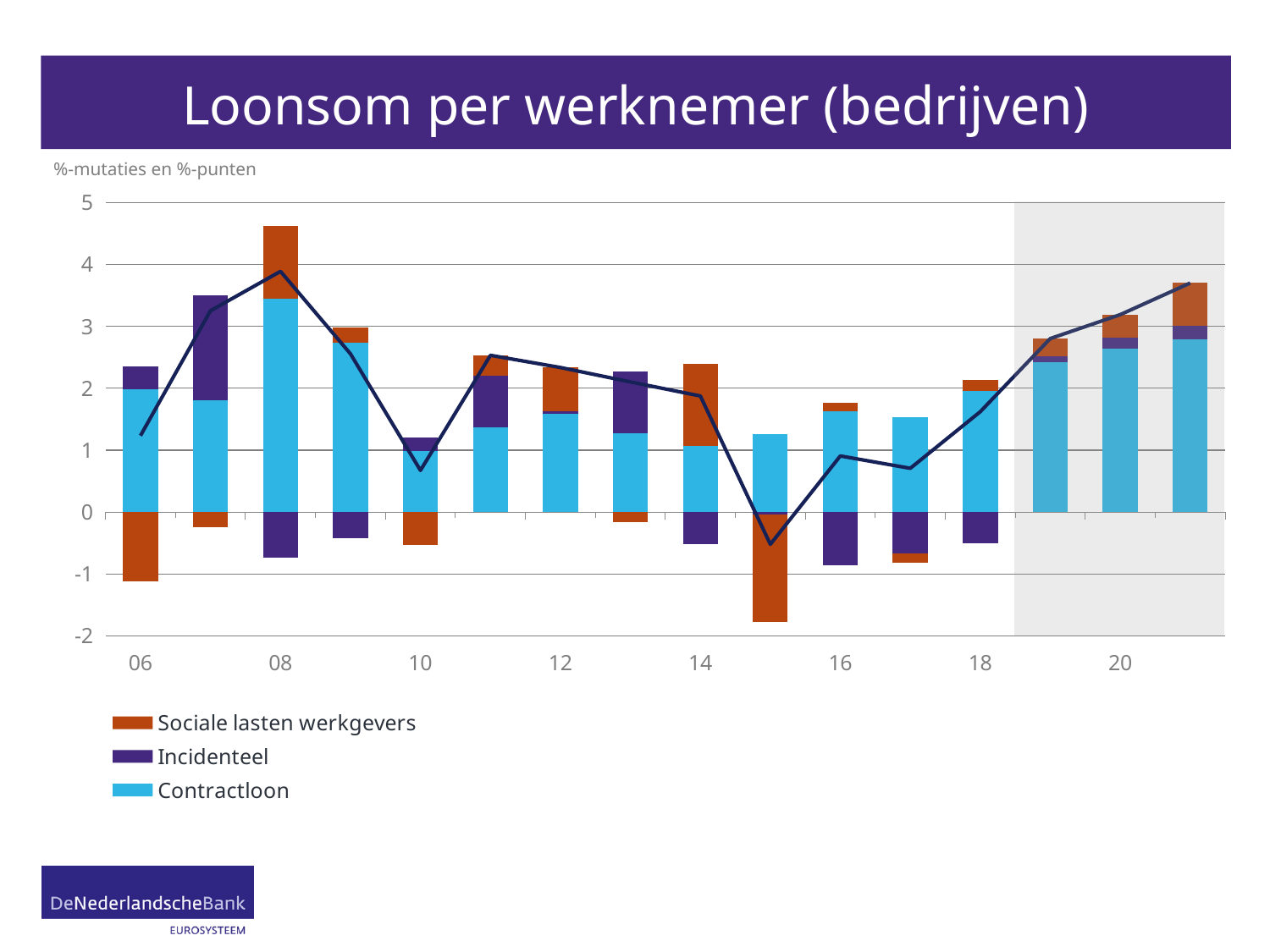
Is the line value for 15 greater or less than 0? less In which year does the line reach its lowest value? 15 How many years (bars) are plotted on the chart? 16 What is the title of the chart? Loonsom per werknemer (bedrijven) Is the Sociale lasten werkgevers value for 15 greater or less than -1? less What unit description is shown above the chart? %-mutaties en %-punten In which year is the Contractloon bar segment the highest? 08 Is the Contractloon value for 08 greater or less than 3? greater Does the line rise or fall from 15 to 21? rise Which year has the larger Contractloon segment, 06 or 08? 08 What kind of chart is shown on the slide? Stacked bar chart with a line How many series does the legend list? 3